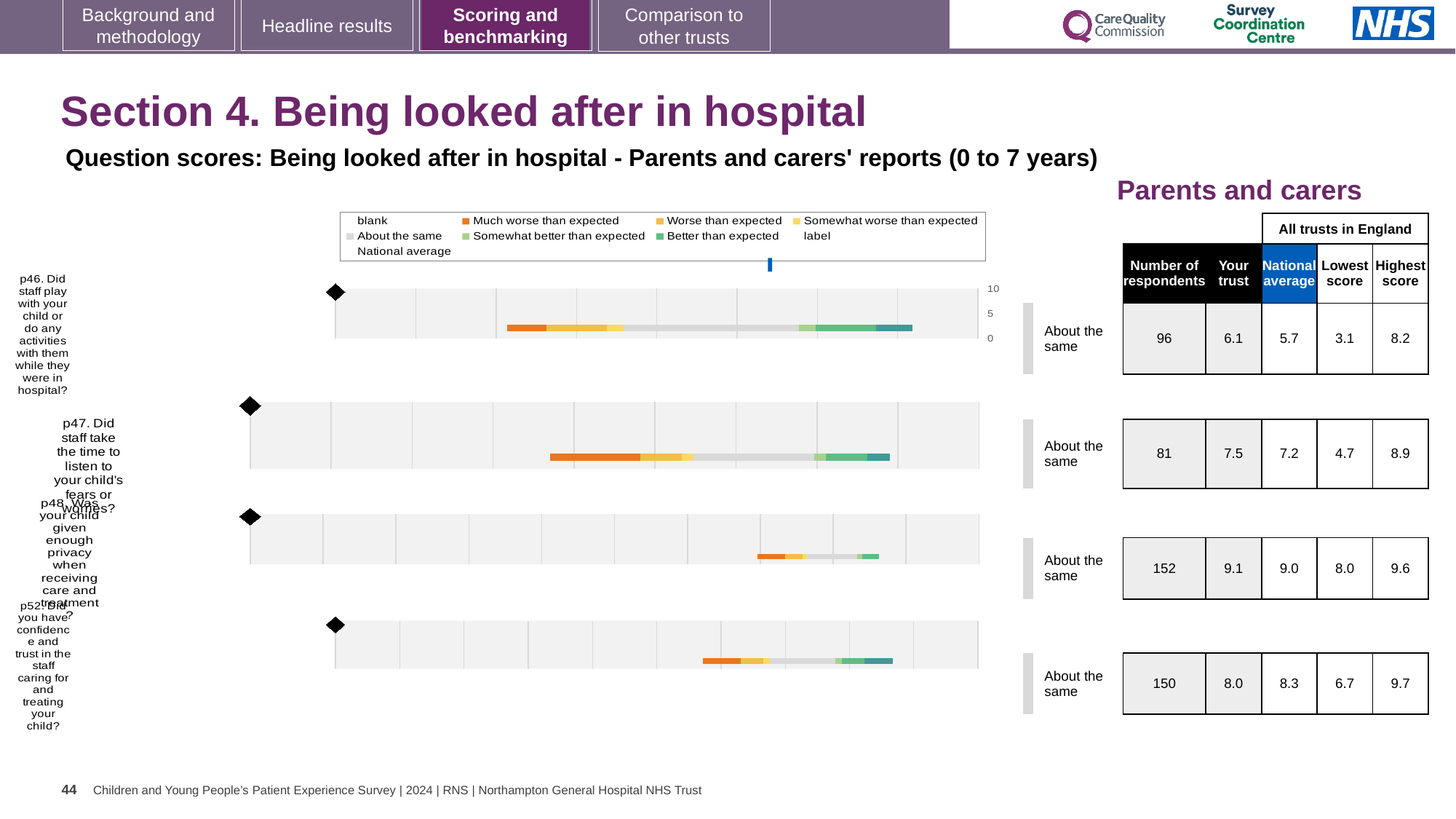
How many respondents are there for p48 (Was your child given enough privacy when receiving care and treatment?)? 152 What kind of chart is used to show the question scores on this slide? bar chart For p52, which is larger: the 'Your trust' score or the national average? National average Which question has the lowest number of respondents? p47 What is the lowest score among all trusts in England for p46? 3.1 How many survey questions (charts) are shown on the slide? 4 For p46 (Did staff play with your child or do any activities with them while they were in hospital?), what is the 'Your trust' score? 6.1 What benchmark category is shown for p46? About the same Which question has the highest 'Your trust' score? p48 For p47, what is the difference between the 'Your trust' score and the national average? 0.3 What is the highest score among all trusts in England for p52 (Did you have confidence and trust in the staff caring for and treating your child?)? 9.7 For p47 (Did staff take the time to listen to your child's fears or worries?), what is the national average score? 7.2